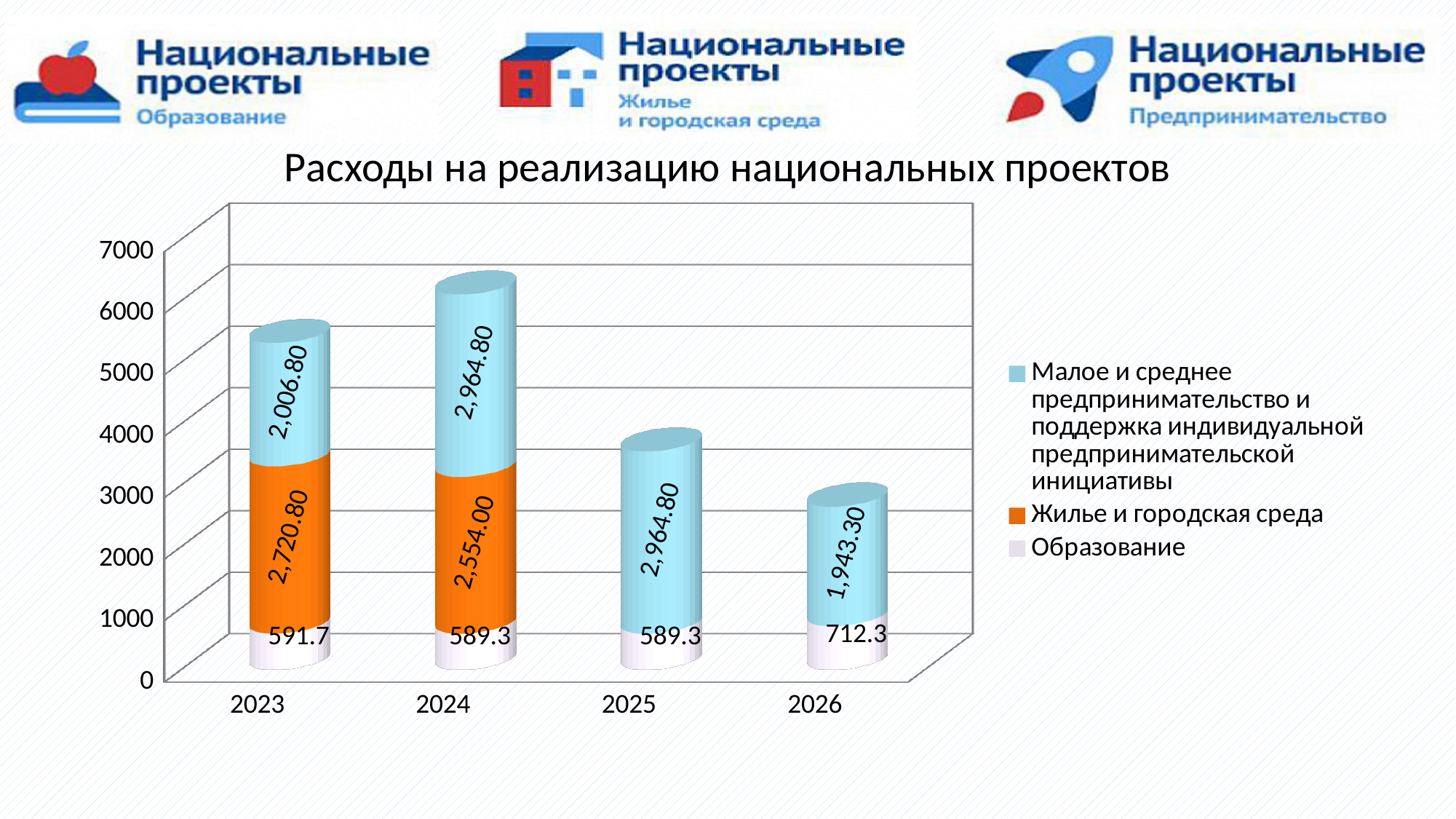
What kind of chart is shown on the slide? Stacked bar chart What is the title of the chart? Расходы на реализацию национальных проектов In which year is the value for Малое и среднее предпринимательство и поддержка индивидуальной предпринимательской инициативы lowest? 2026 How many years are shown on the x axis? 4 Which is larger: the Образование value for 2023 or for 2026? 2026 How many series does the legend list? 3 What is the total of the stacked bar for 2025? 3,554.1 What is the value for Образование in 2023? 591.7 What is the value for Малое и среднее предпринимательство и поддержка индивидуальной предпринимательской инициативы in 2026? 1,943.30 What is the value for Жилье и городская среда in 2024? 2,554.00 What is the difference between the Жилье и городская среда values for 2023 and 2024? 166.80 In which year is the value for Образование highest? 2026